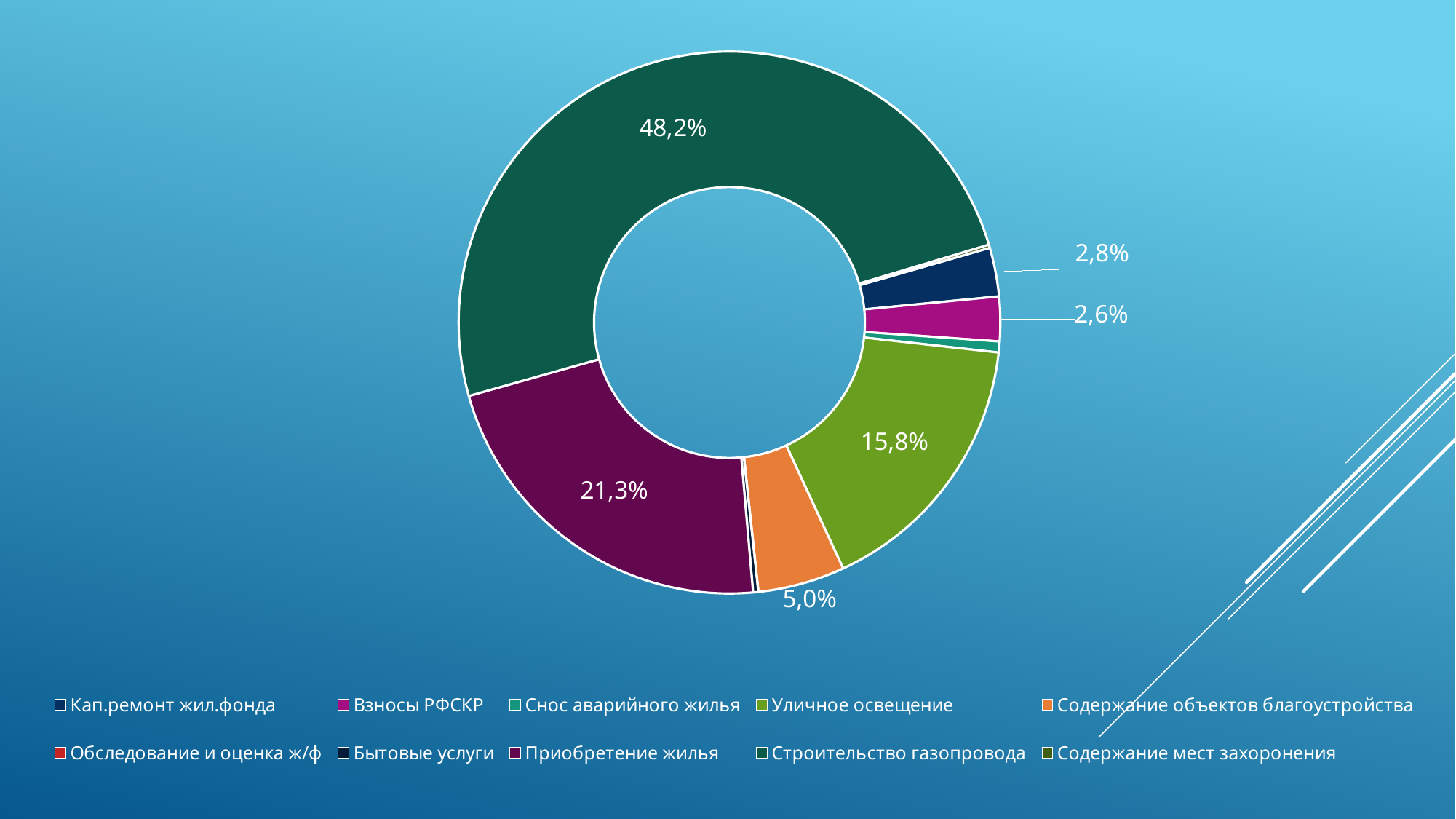
What value is labelled on the Уличное освещение slice? 15,8% Which category has the largest share of the chart? Строительство газопровода What colour is the Содержание объектов благоустройства slice? Orange What share of the doughnut chart does Строительство газопровода account for? 48,2% What is the difference in percentage points between Строительство газопровода and Приобретение жилья? 26,9% What type of chart is shown on the slide? Doughnut (pie) chart What percentage is labelled for Кап.ремонт жил.фонда? 2,8% What share is shown for Содержание объектов благоустройства? 5,0% What percentage is labelled for Взносы РФСКР? 2,6% How many categories does the legend list? 10 Which is larger, the share for Уличное освещение or the share for Приобретение жилья? Приобретение жилья What percentage is shown for Приобретение жилья? 21,3%